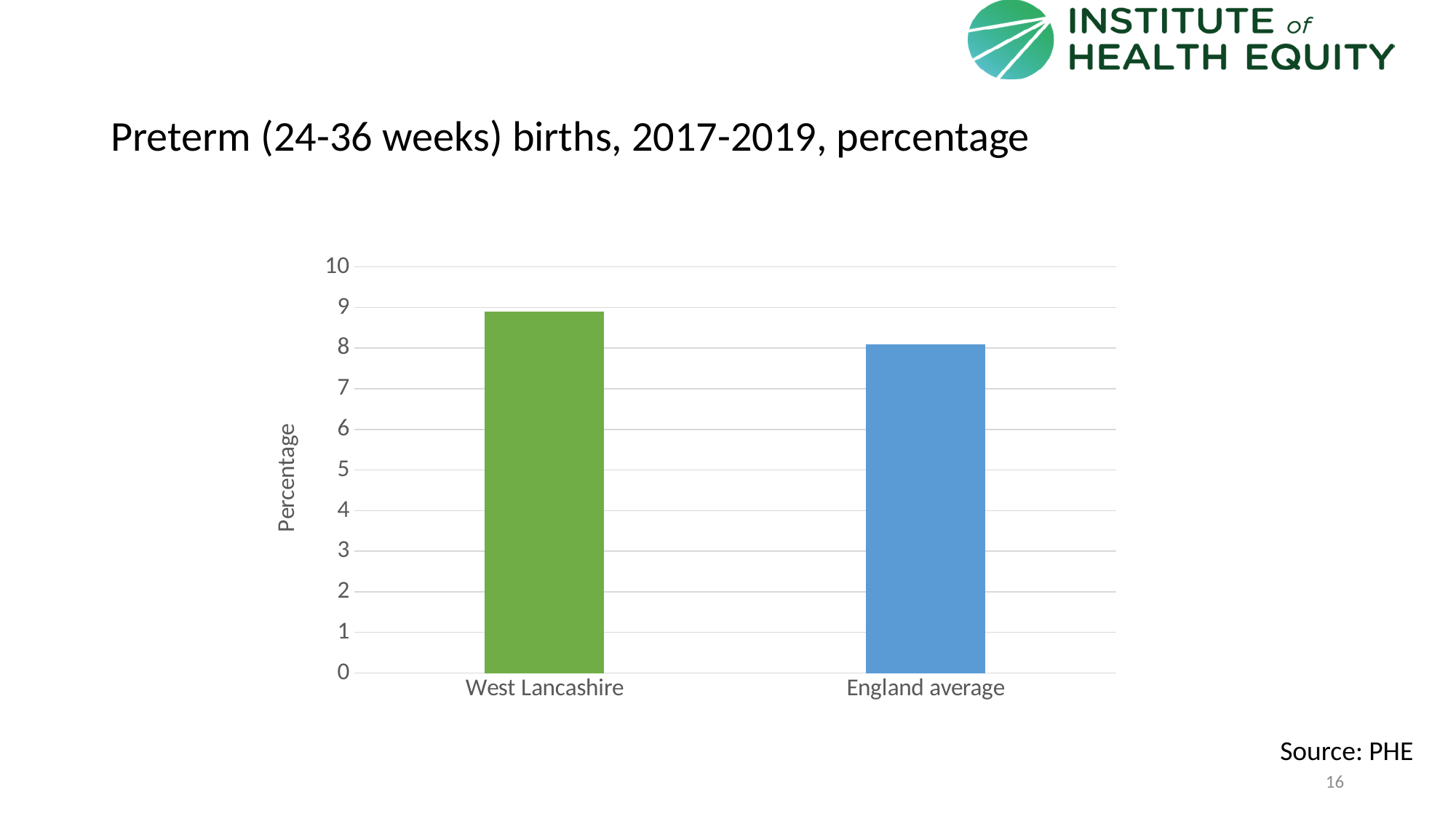
What is the title of the chart? Preterm (24-36 weeks) births, 2017-2019, percentage Which category has the highest preterm birth percentage? West Lancashire Is the value for England average greater or less than 7? greater Is the value for West Lancashire greater or less than 8? greater What is the maximum value shown on the vertical axis? 10 Is the preterm birth percentage for West Lancashire greater or less than the England average? greater How many categories are plotted in the chart? 2 Which category has the lowest preterm birth percentage? England average Is the value for England average greater or less than 9? less What is the label on the vertical axis? Percentage What kind of chart is shown on the slide? bar chart